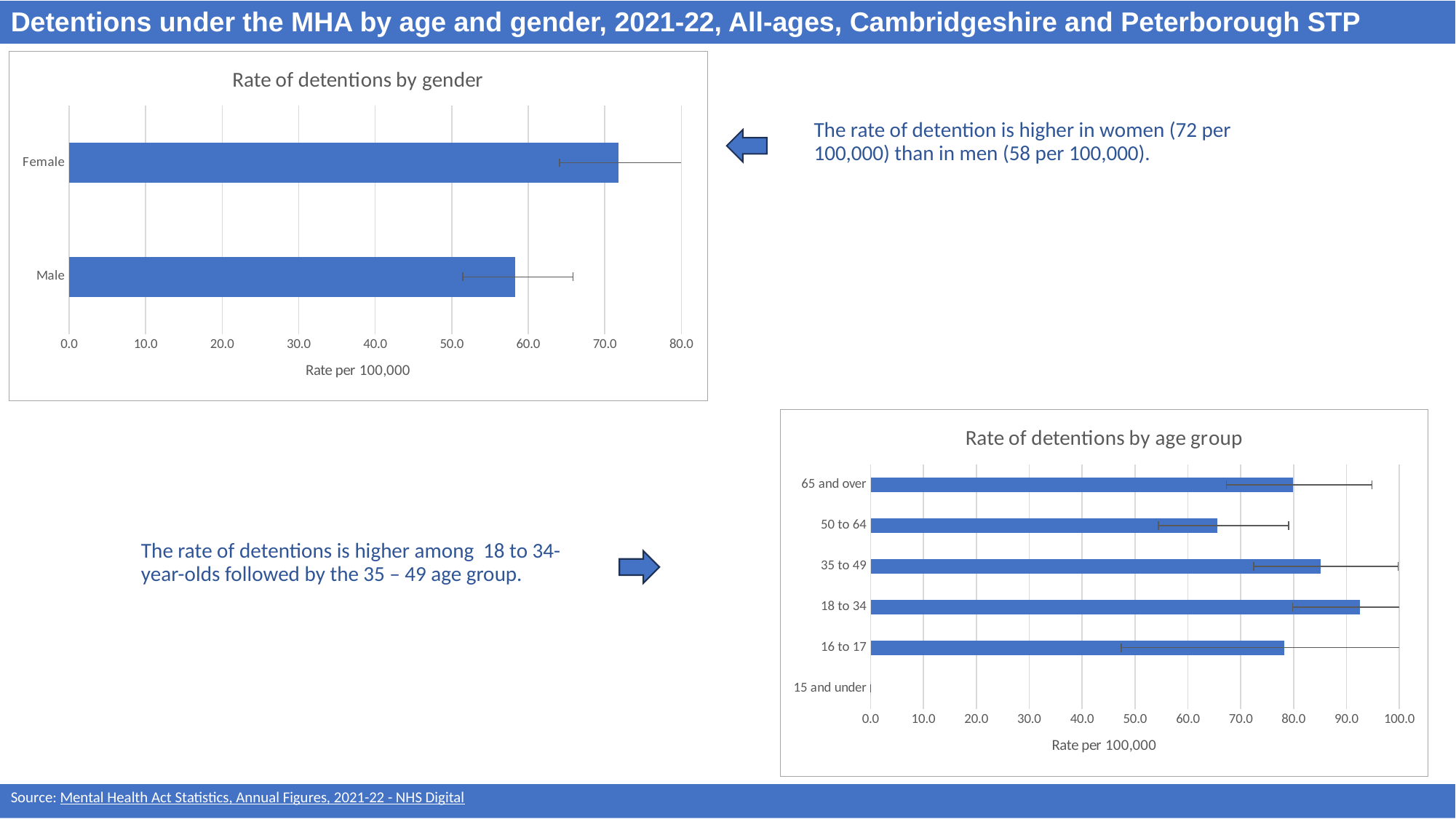
On the 'Rate of detentions by gender' chart, what is the difference between the female and male rates per 100,000? 14 On the 'Rate of detentions by age group' chart, is the value for 50 to 64 greater or less than 70? less On the 'Rate of detentions by age group' chart, what is the label of the horizontal axis? Rate per 100,000 On the 'Rate of detentions by gender' chart, what is the rate of detention for men per 100,000? 58 On the 'Rate of detentions by age group' chart, which age group has the highest rate of detentions? 18 to 34 On the 'Rate of detentions by gender' chart, what is the rate of detention for women per 100,000? 72 On the 'Rate of detentions by age group' chart, is the value for 16 to 17 greater or less than 70? greater On the 'Rate of detentions by gender' chart, what kind of chart is shown? Bar chart On the 'Rate of detentions by age group' chart, how many age group categories are listed on the vertical axis? 6 On the 'Rate of detentions by gender' chart, which gender has the higher rate of detention? Female On the 'Rate of detentions by age group' chart, which has the higher rate: 35 to 49 or 50 to 64? 35 to 49 On the 'Rate of detentions by age group' chart, is the value for 18 to 34 greater or less than 90? greater